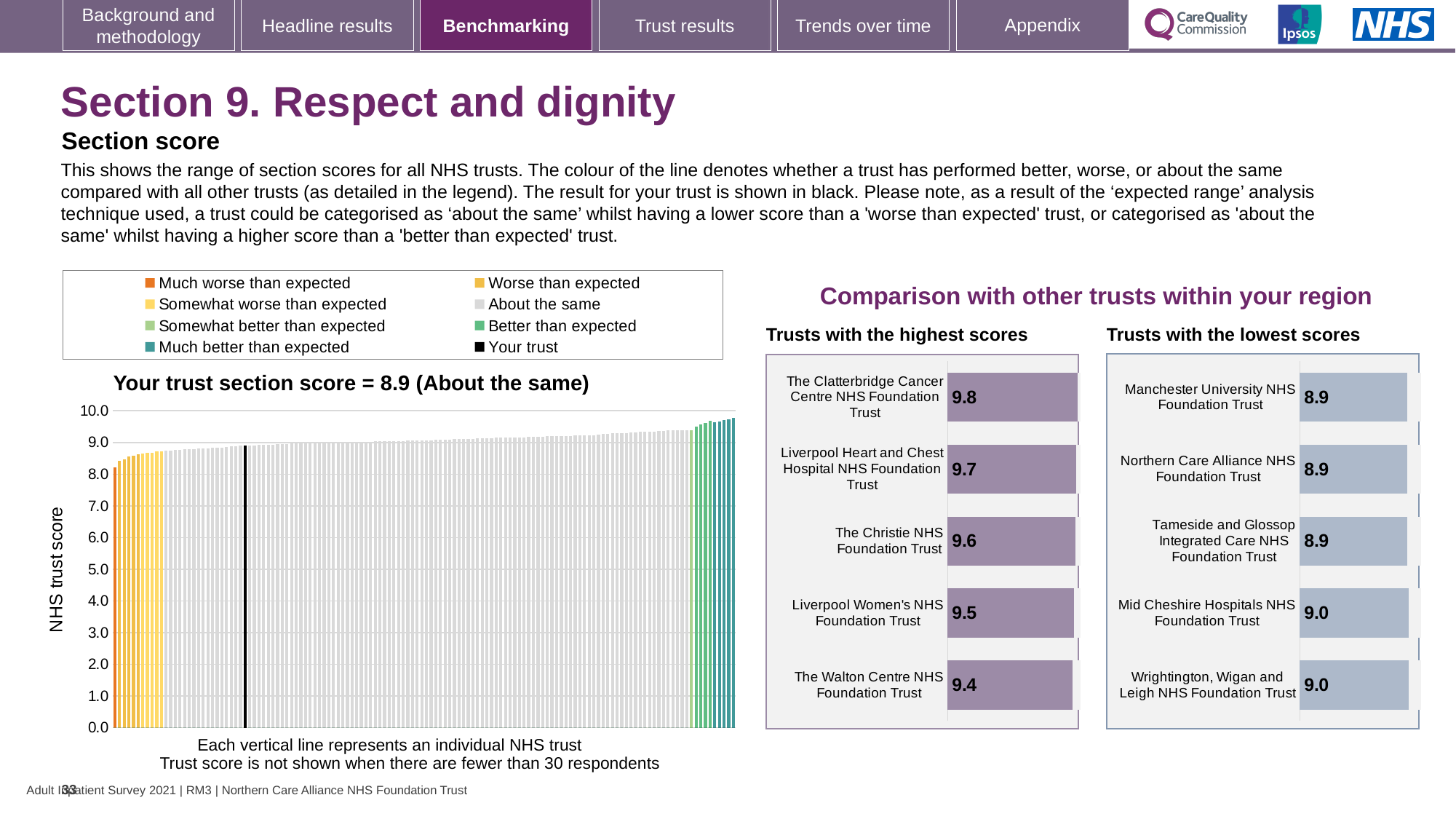
In the 'Your trust section score' chart, do the trust scores rise or fall from left to right along the x axis? Rise In the 'Trusts with the lowest scores' chart, which has the larger score: Mid Cheshire Hospitals NHS Foundation Trust or Manchester University NHS Foundation Trust? Mid Cheshire Hospitals NHS Foundation Trust What kind of chart is the 'Your trust section score' chart? Bar chart In the 'Trusts with the highest scores' chart, what is the difference between the scores of The Clatterbridge Cancer Centre NHS Foundation Trust and The Walton Centre NHS Foundation Trust? 0.4 How many entries does the legend above the 'Your trust section score' chart list? 8 In the 'Trusts with the highest scores' chart, what is the score for The Christie NHS Foundation Trust? 9.6 In the 'Your trust section score' chart, what is the section score for your trust? 8.9 In the 'Trusts with the highest scores' chart, which trust has the highest score? The Clatterbridge Cancer Centre NHS Foundation Trust In the 'Trusts with the lowest scores' chart, what is the score for Tameside and Glossop Integrated Care NHS Foundation Trust? 8.9 In the 'Trusts with the lowest scores' chart, what is the score for Mid Cheshire Hospitals NHS Foundation Trust? 9.0 In the 'Trusts with the highest scores' chart, how many trusts are shown? 5 In the 'Trusts with the highest scores' chart, which trust has the lowest score? The Walton Centre NHS Foundation Trust